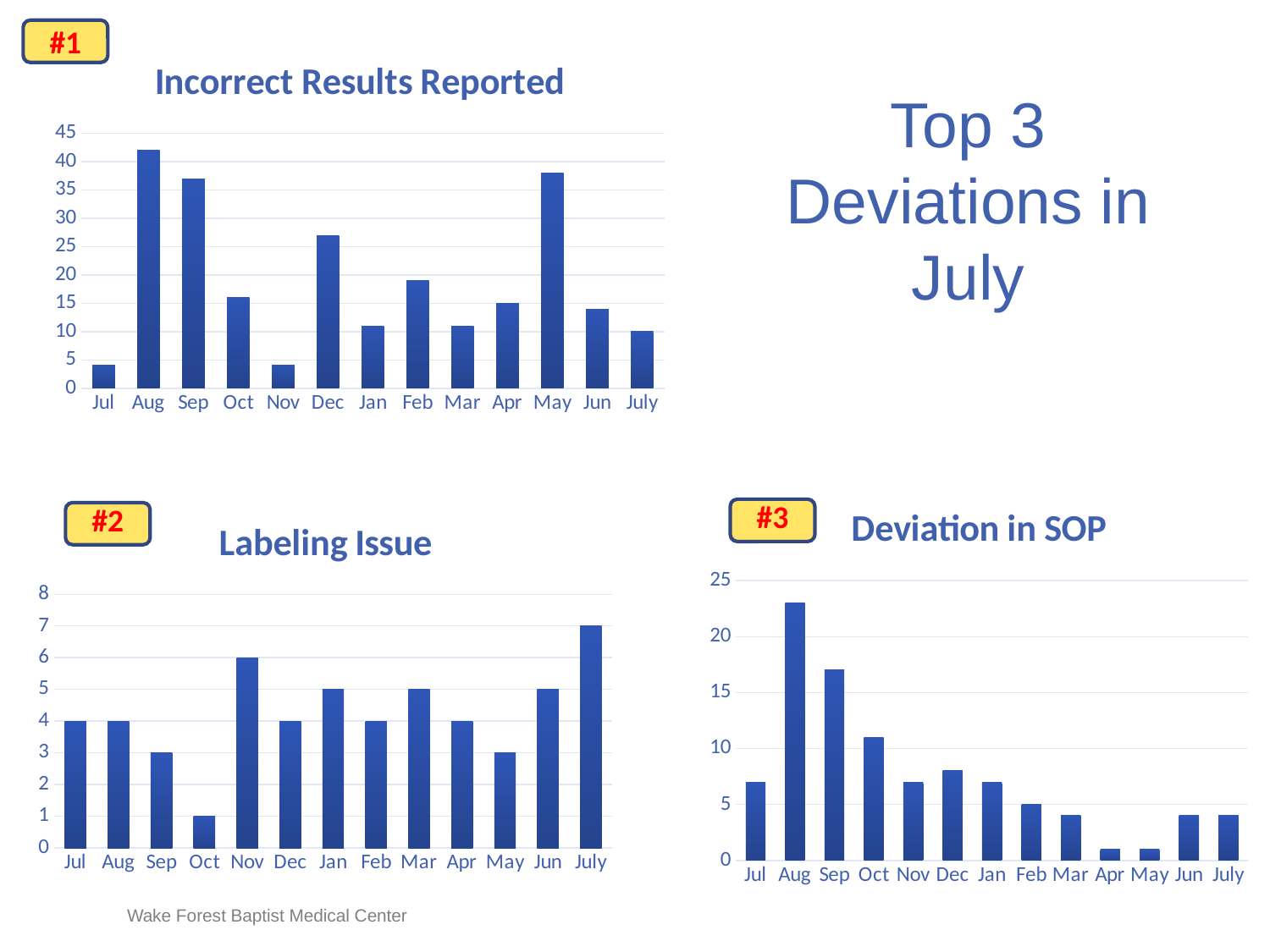
In the Labeling Issue chart, which month has the lowest value? Oct In the Incorrect Results Reported chart, is the value for Dec greater or less than 25? greater In the Labeling Issue chart, what is the value for Oct? 1 In the Incorrect Results Reported chart, which month has the highest value? Aug In the Labeling Issue chart, what is the value for July? 7 In the Labeling Issue chart, which month has the highest value? July How many months are shown on the x axis of the Deviation in SOP chart? 13 In the Labeling Issue chart, what is the difference between the values for July and Oct? 6 In the Incorrect Results Reported chart, which is larger, the value for Sep or the value for Oct? Sep In the Deviation in SOP chart, is the value for Sep greater or less than 15? greater In the Deviation in SOP chart, which month has the highest value? Aug In the Labeling Issue chart, what is the value for Nov? 6